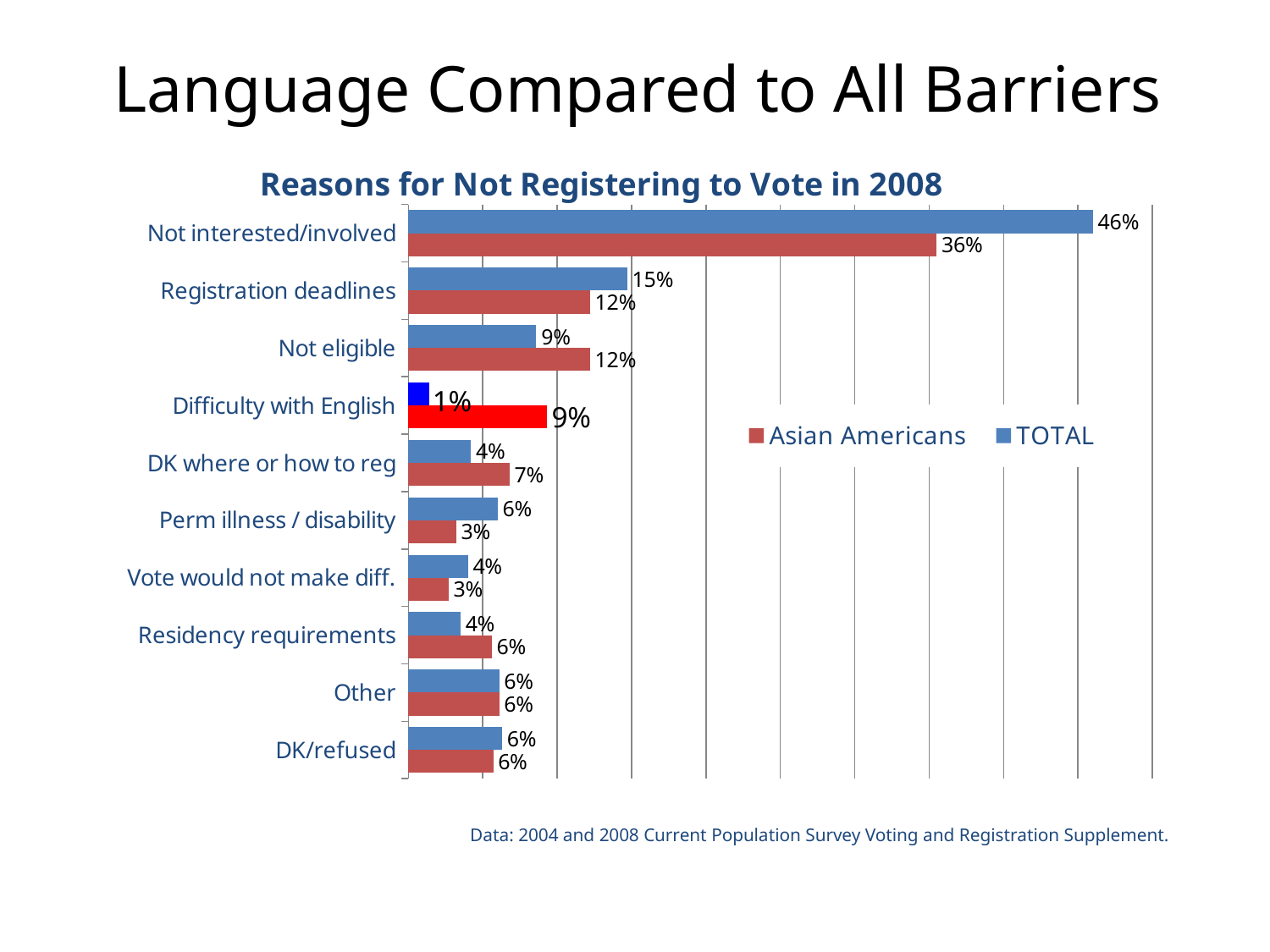
How many categories are shown on the chart? 10 What is the Asian Americans value for Difficulty with English? 9% How many series does the legend list? 2 What kind of chart is shown on the slide? Bar chart Which category has the lowest TOTAL value? Difficulty with English What is the TOTAL value for Not interested/involved? 46% What is the title of the chart? Reasons for Not Registering to Vote in 2008 Which category has the highest Asian Americans value? Not interested/involved For Not eligible, which series has the larger value, Asian Americans or TOTAL? Asian Americans What is the TOTAL value for Difficulty with English? 1% What is the difference between the TOTAL and Asian Americans values for Not interested/involved? 10% What is the Asian Americans value for Registration deadlines? 12%